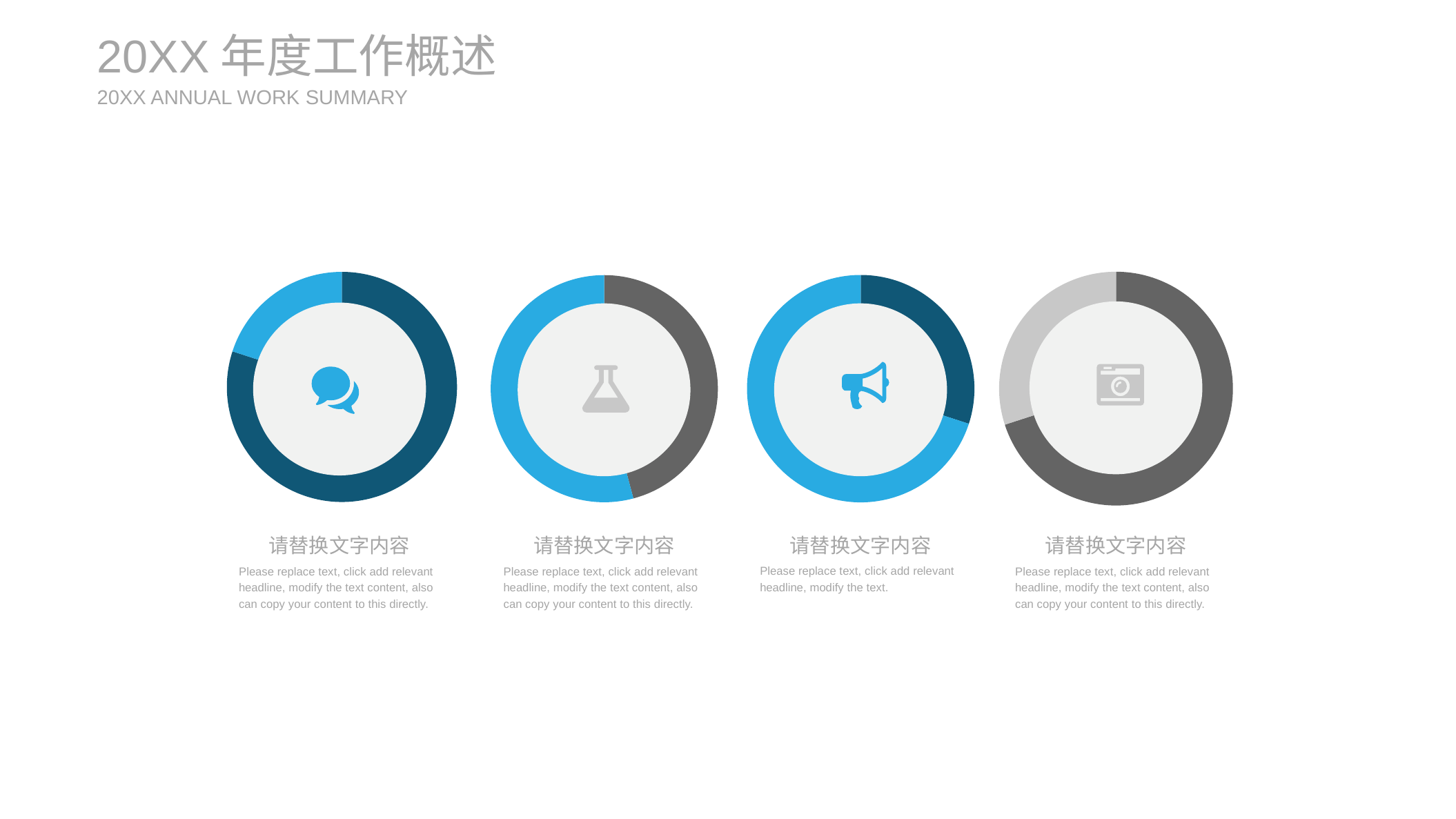
What kind of chart is the leftmost chart on the slide? Donut chart In the rightmost donut chart, how many segments does the ring have? 2 How many donut charts are shown on the slide? 4 In the leftmost donut chart, how many segments does the ring have? 2 In the third donut chart from the left, which segment is larger, the light blue one or the dark blue one? Light blue In the second donut chart from the left, which segment is larger, the light blue one or the grey one? Light blue What icon appears in the centre of the third donut chart from the left? A megaphone In the leftmost donut chart, which segment is larger, the dark blue one or the light blue one? Dark blue Which two colours are used for the segments of the second donut chart from the left? Light blue and grey